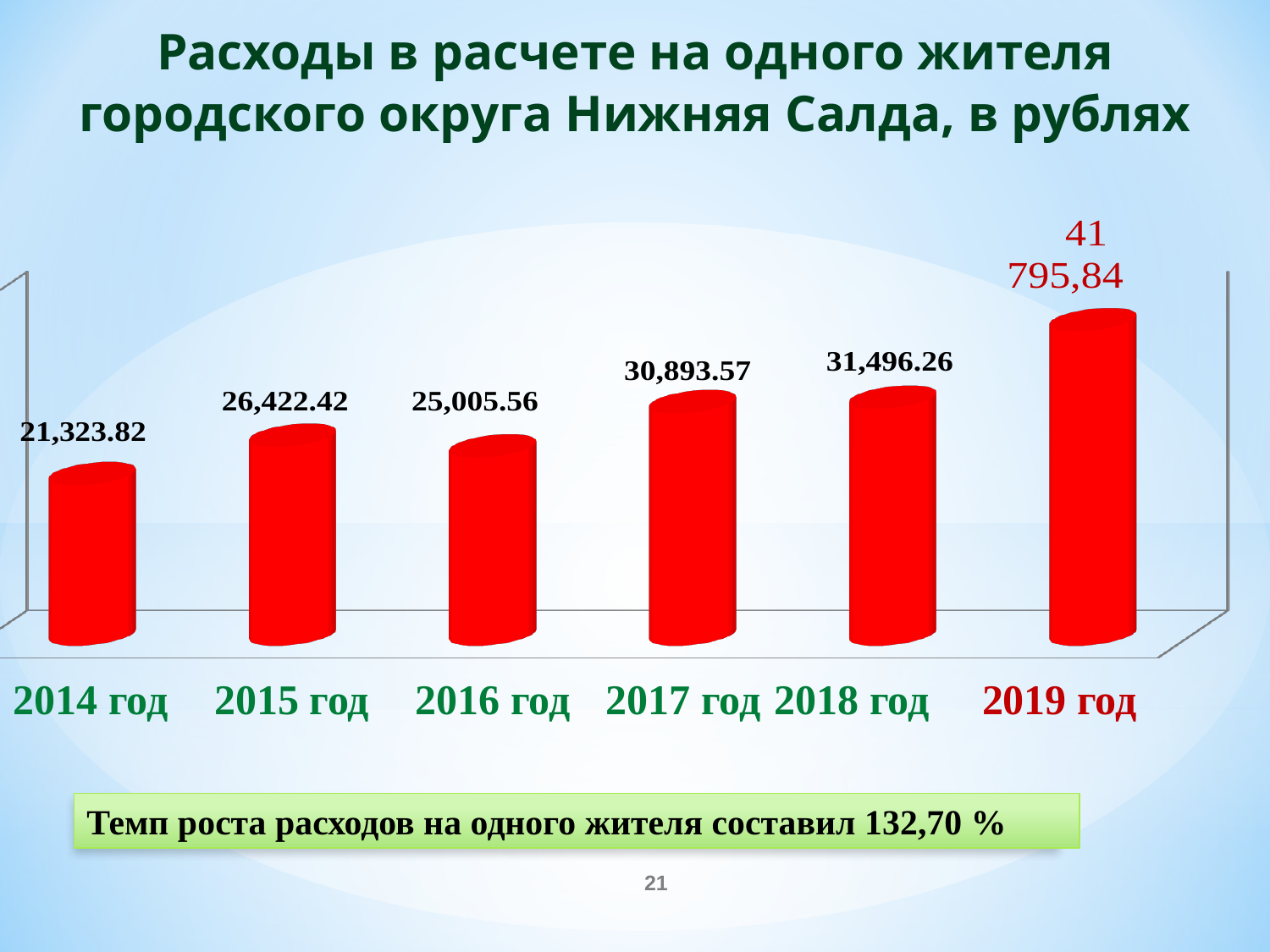
Which is larger, the value for 2015 год or 2016 год? 2015 год How many years are shown on the chart? 6 What is the value for 2019 год? 41 795,84 What is the difference between the values for 2015 год and 2014 год? 5,098.60 What is the value for 2016 год? 25,005.56 What kind of chart is shown on the slide? Bar chart What is the difference between the values for 2018 год and 2017 год? 602.69 Which year has the highest value? 2019 год Which year has the lowest value? 2014 год What is the value for 2017 год? 30,893.57 What growth rate of expenses per resident is stated in the box below the chart? 132,70 % What is the value for 2014 год? 21,323.82